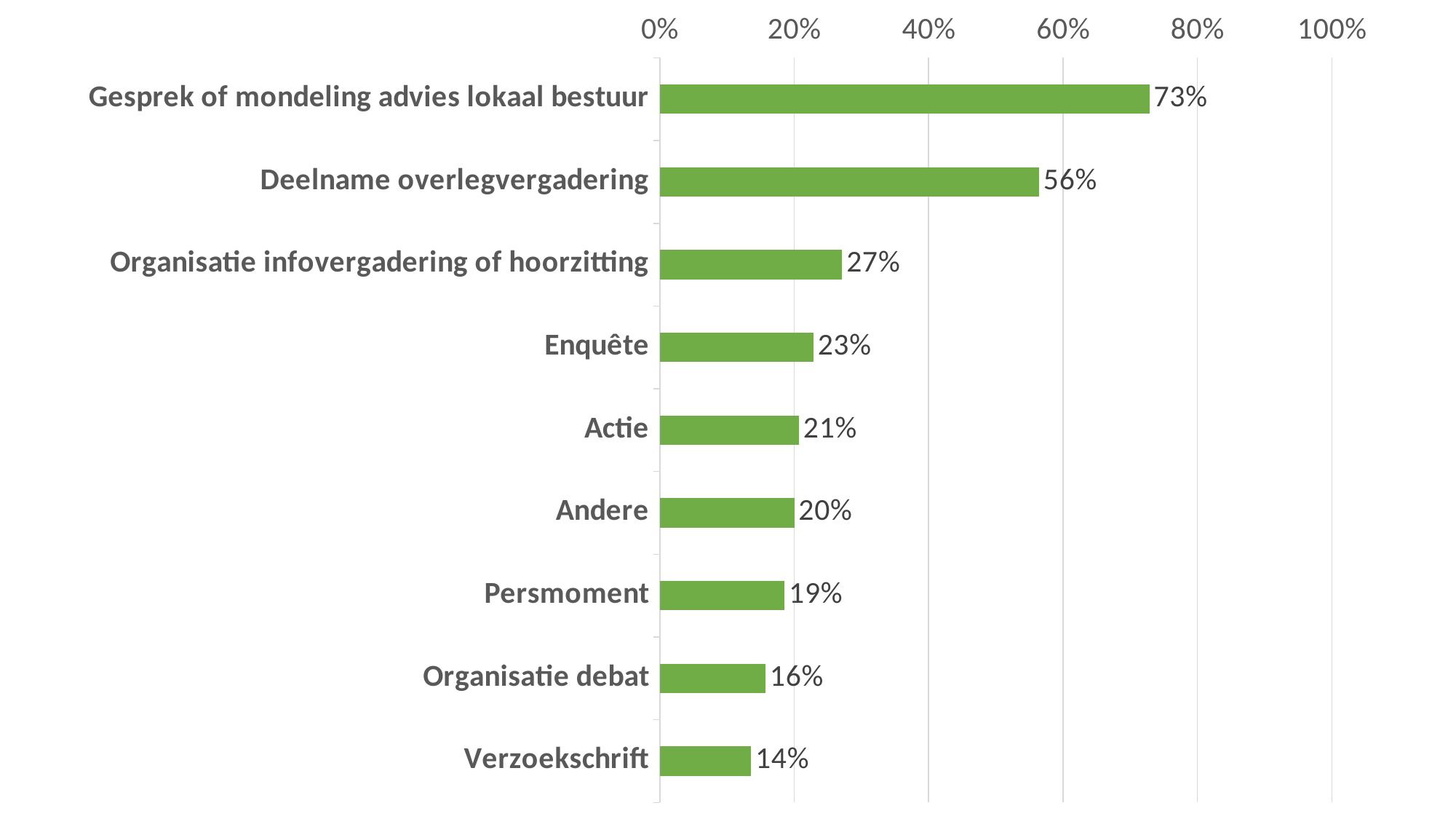
Which category has the lowest value? Verzoekschrift What is the value for Organisatie debat? 16% What is the difference between the values for Gesprek of mondeling advies lokaal bestuur and Deelname overlegvergadering? 17% Which category has the highest value? Gesprek of mondeling advies lokaal bestuur What is the value for Enquête? 23% What colour are the bars in the chart? Green What is the difference between the values for Organisatie infovergadering of hoorzitting and Verzoekschrift? 13% What kind of chart is shown on the slide? Bar chart Which is larger, the value for Actie or the value for Persmoment? Actie Is the value for Deelname overlegvergadering greater or less than 40%? greater How many categories are shown in the chart? 9 What is the value for Gesprek of mondeling advies lokaal bestuur? 73%